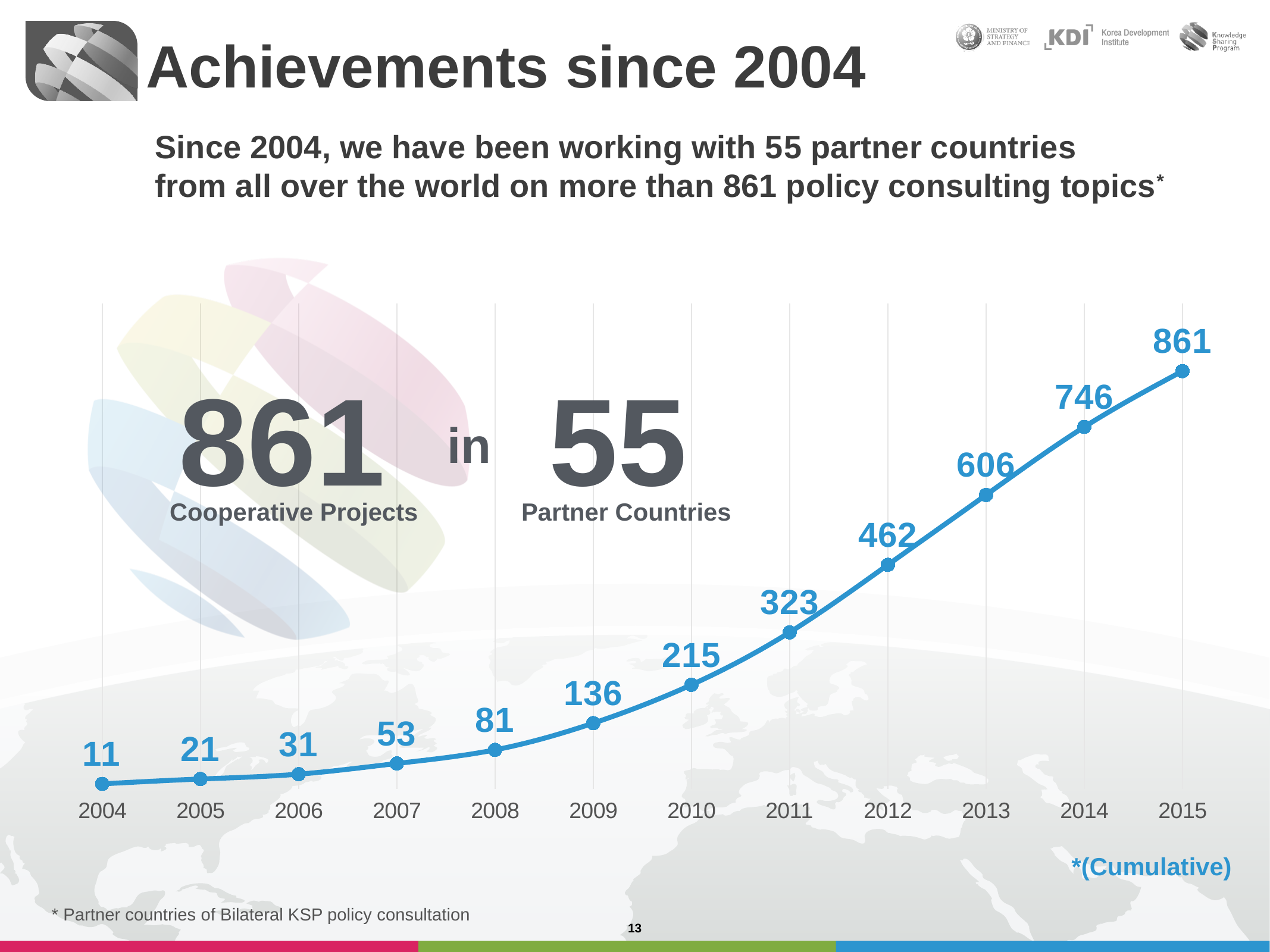
How many years are plotted on the line chart? 12 What is the difference between the values for 2015 and 2014? 115 Which is larger, the value for 2009 or the value for 2008? 2009 What is the cumulative value shown for 2010? 215 What is the difference between the values for 2012 and 2011? 139 Which year has the highest value on the line chart? 2015 What kind of chart is shown on the slide? Line chart What is the cumulative value shown for 2013? 606 What is the cumulative value shown for 2004? 11 Which year has the lowest value on the line chart? 2004 Do the values rise or fall from 2004 to 2015? Rise What colour is the line on the chart? Blue